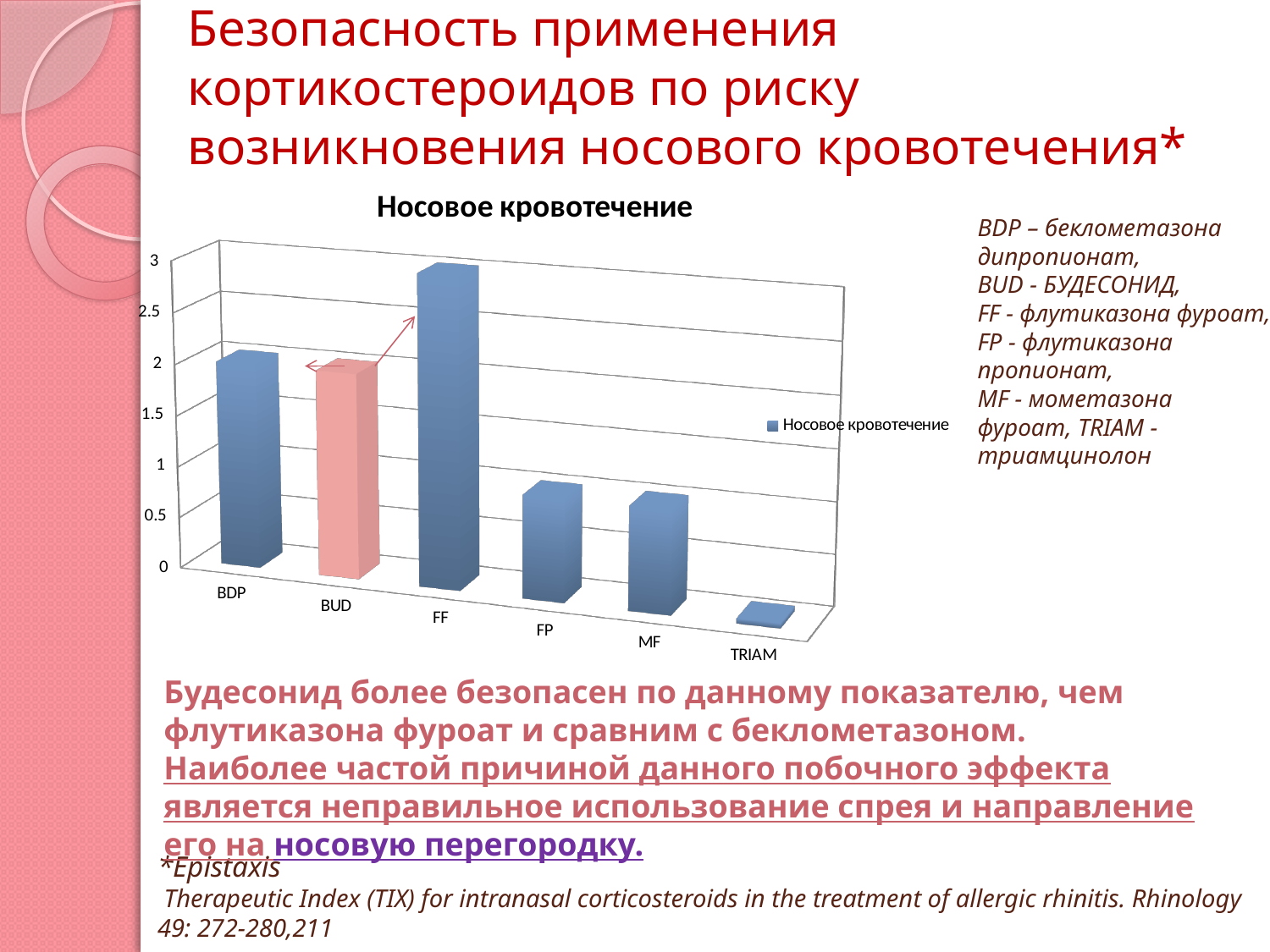
Which category's bar is coloured differently (pink) from the other blue bars? BUD Which has the larger value, FF or FP? FF How many series does the chart legend list? 1 Is the value for TRIAM greater or less than 0.5? less How many categories are shown on the x axis of the chart? 6 Is the value for FF greater or less than 2.5? greater Which category has the highest value in the chart? FF Which has the larger value, BDP or TRIAM? BDP What is the title of the chart? Носовое кровотечение Is the value for FP greater or less than 1.5? less Which category has the lowest value in the chart? TRIAM What kind of chart is shown on the slide? bar chart